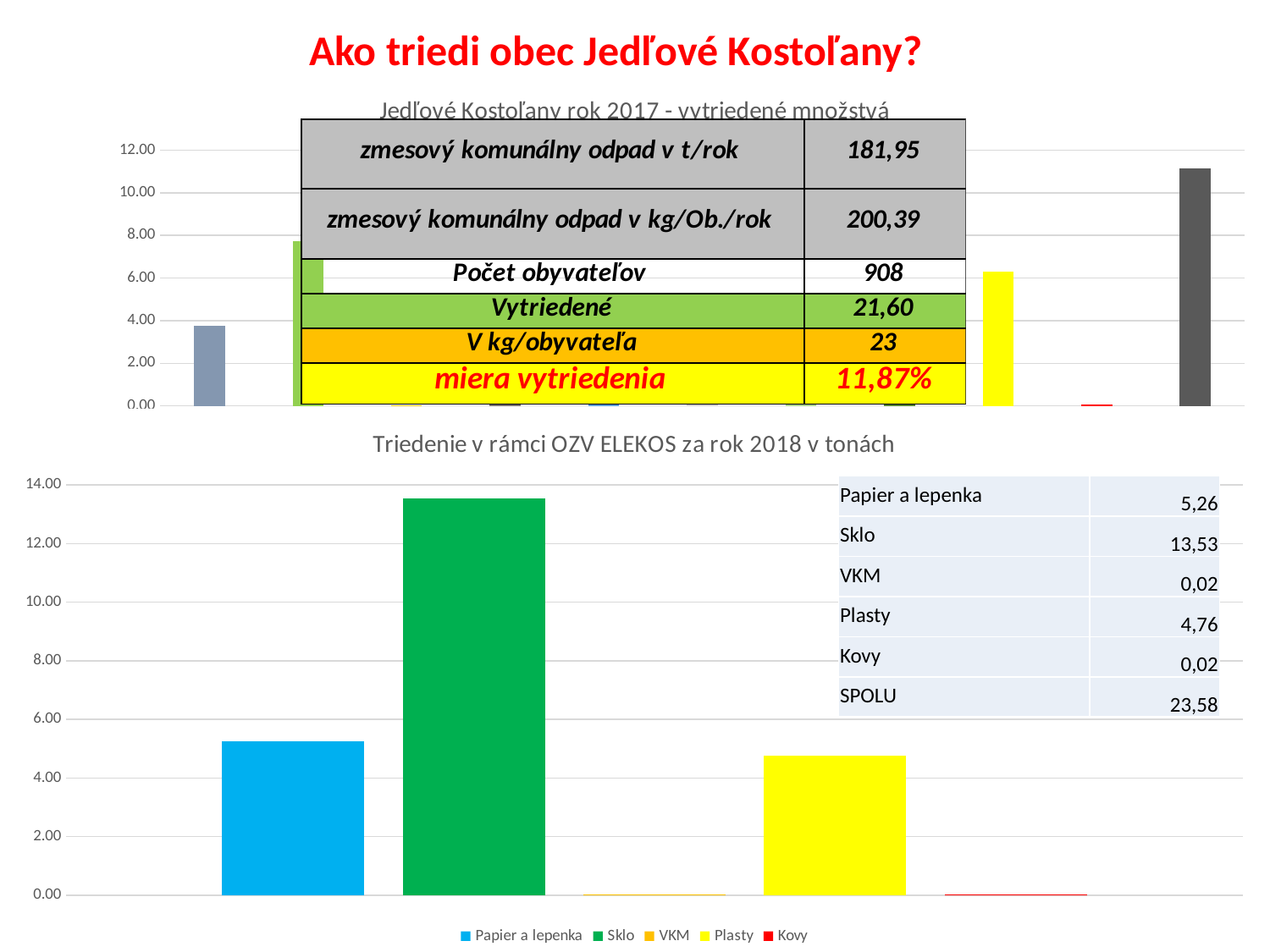
In the chart 'Triedenie v rámci OZV ELEKOS za rok 2018 v tonách', is the value for Sklo greater or less than 12? greater In the chart 'Triedenie v rámci OZV ELEKOS za rok 2018 v tonách', which category has the highest value? Sklo What kind of chart is 'Triedenie v rámci OZV ELEKOS za rok 2018 v tonách'? bar chart In the chart 'Triedenie v rámci OZV ELEKOS za rok 2018 v tonách', what is the value for Plasty? 4,76 In the chart 'Triedenie v rámci OZV ELEKOS za rok 2018 v tonách', what is the difference between Sklo and Papier a lepenka? 8,27 In the chart 'Triedenie v rámci OZV ELEKOS za rok 2018 v tonách', what colour is the bar for Sklo? green In the chart 'Triedenie v rámci OZV ELEKOS za rok 2018 v tonách', which is larger, Papier a lepenka or Plasty? Papier a lepenka How many series does the legend of the chart 'Triedenie v rámci OZV ELEKOS za rok 2018 v tonách' list? 5 In the chart 'Triedenie v rámci OZV ELEKOS za rok 2018 v tonách', what is the value for Papier a lepenka? 5,26 In the chart 'Triedenie v rámci OZV ELEKOS za rok 2018 v tonách', what is the total (SPOLU) of all categories? 23,58 In the chart 'Triedenie v rámci OZV ELEKOS za rok 2018 v tonách', what is the value for Sklo? 13,53 What is the title of the top chart on the slide? Jedľové Kostoľany rok 2017 - vytriedené množstvá